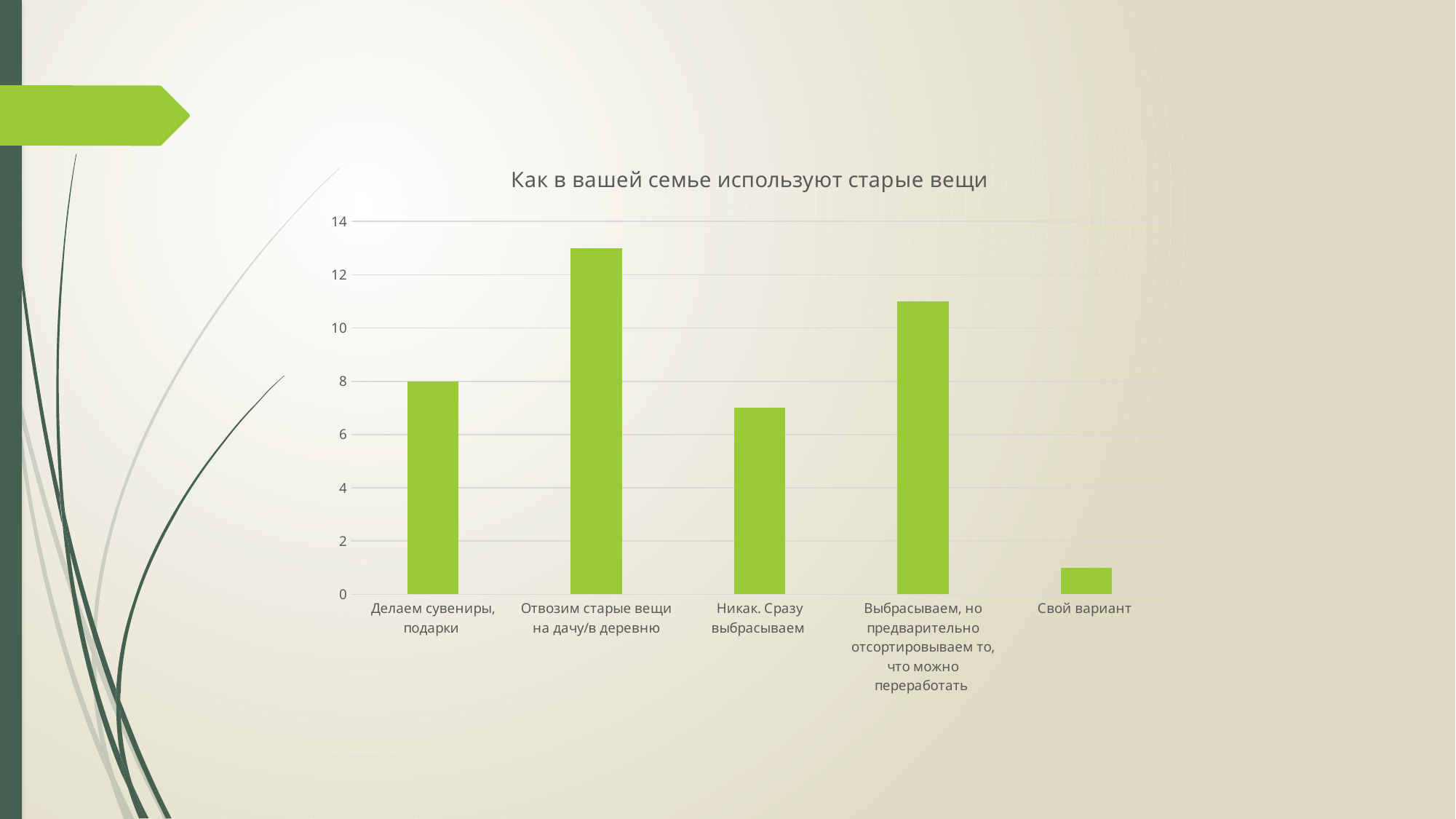
What type of chart is shown on the slide? Bar chart Which is larger: the value for "Выбрасываем, но предварительно отсортировываем то, что можно переработать" or the value for "Делаем сувениры, подарки"? Выбрасываем, но предварительно отсортировываем то, что можно переработать Is the value for "Выбрасываем, но предварительно отсортировываем то, что можно переработать" greater or less than 10? greater What colour are the bars in the chart? Green Which category has the highest bar? Отвозим старые вещи на дачу/в деревню Is the value for "Никак. Сразу выбрасываем" greater or less than 8? less What is the title of the chart? Как в вашей семье используют старые вещи Is the value for "Свой вариант" greater or less than 2? less What is the value for "Делаем сувениры, подарки"? 8 Which category has the lowest bar? Свой вариант How many categories are shown on the x axis of the chart? 5